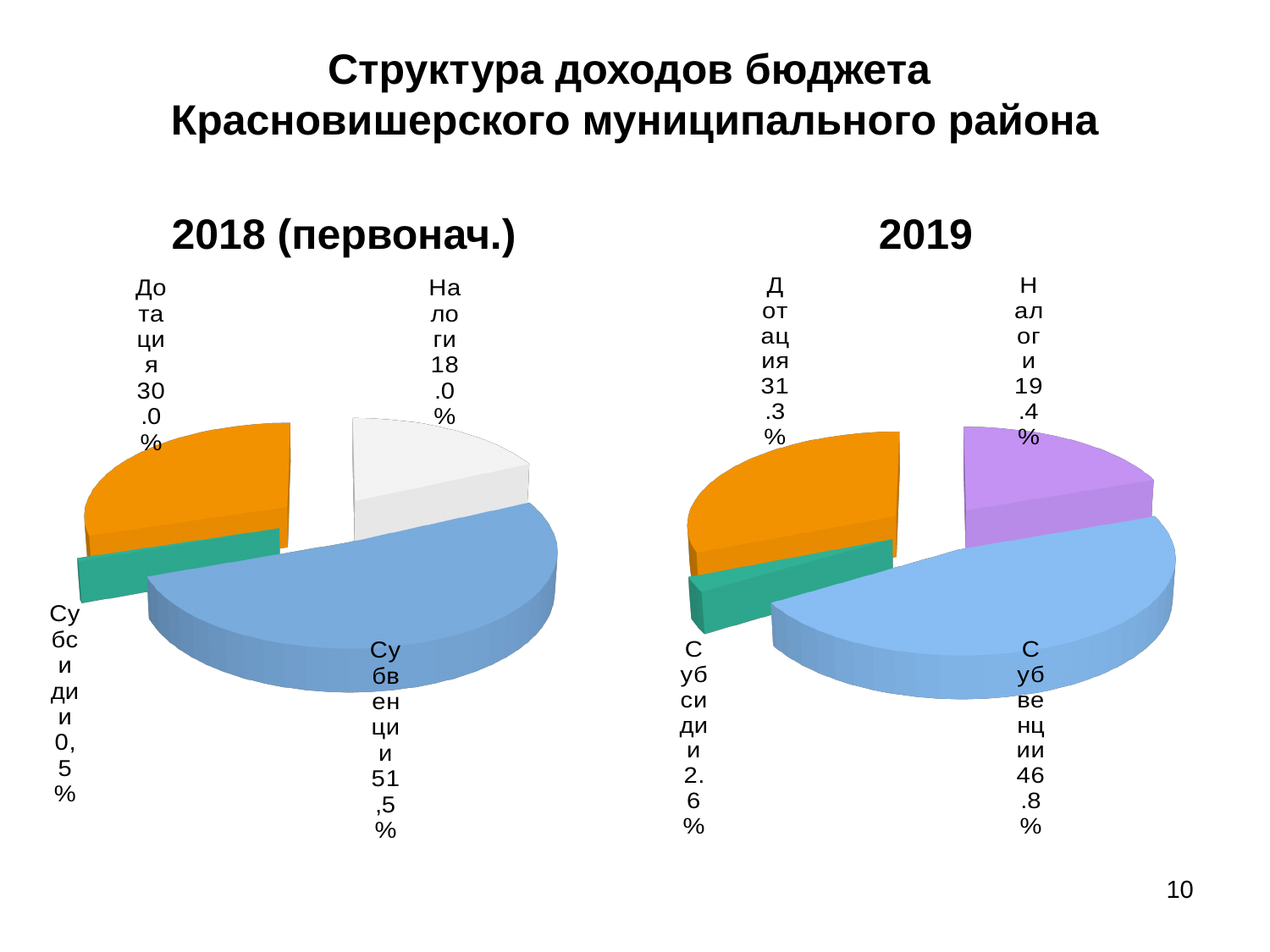
In the 2019 chart, which category has the largest share? Субвенции What is the title of the slide? Структура доходов бюджета Красновишерского муниципального района In the 2018 (первонач.) chart, which category has the smallest share? Субсидии In the 2019 chart, what share is Субсидии? 2.6% In the 2018 (первонач.) chart, what share is Дотация? 30.0% What type of chart is used for 2018 (первонач.)? Pie chart In the 2018 (первонач.) chart, which is larger: Дотация or Налоги? Дотация In the 2018 (первонач.) chart, what share is Налоги? 18.0% In the 2019 chart, what share is Налоги? 19.4% In the 2019 chart, what is the difference between the shares of Дотация and Налоги? 11.9% How many slices does the 2019 chart have? 4 In the 2018 (первонач.) chart, what share is Субвенции? 51,5%